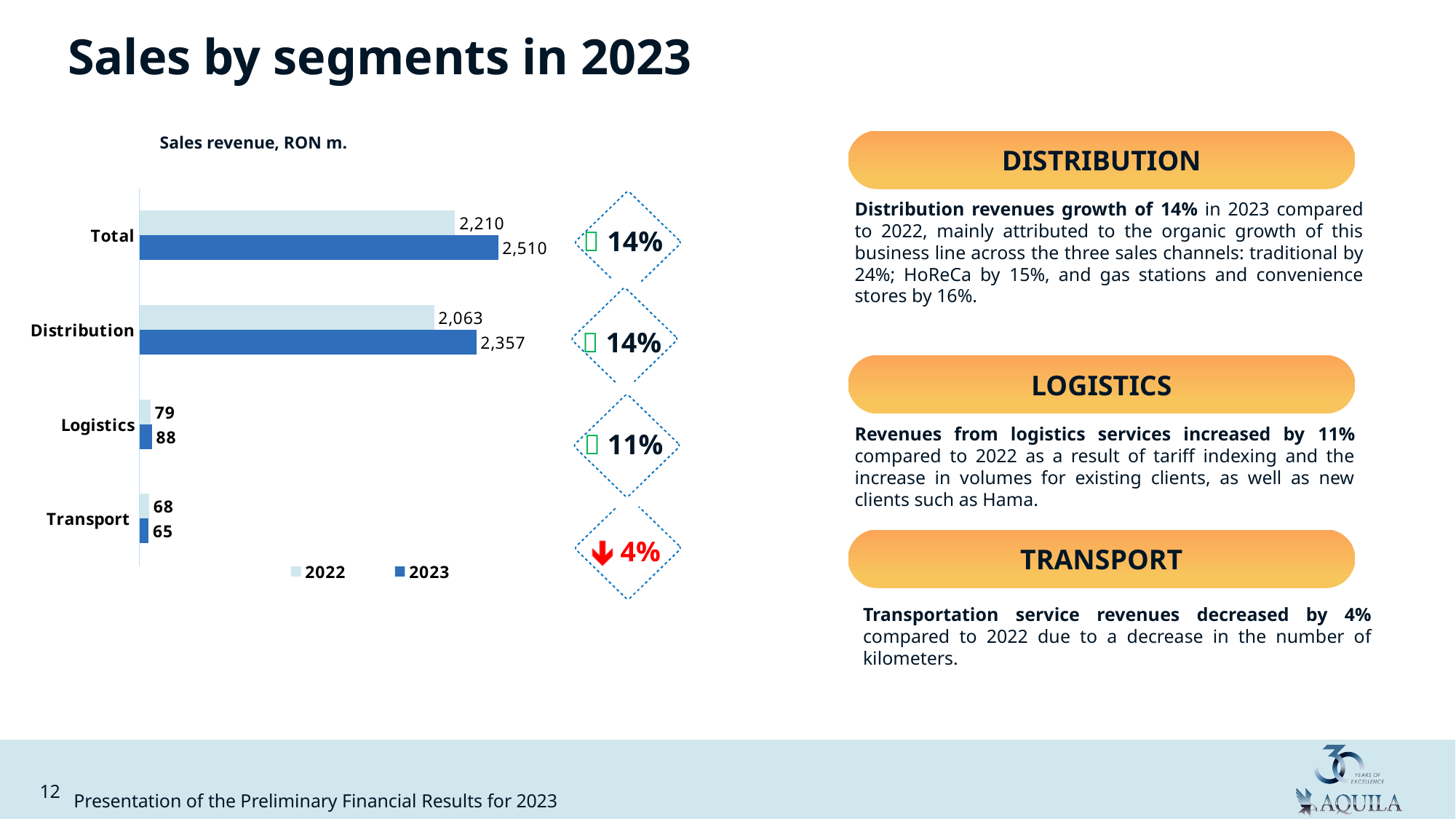
Excluding Total, which segment had the highest sales revenue in 2023? Distribution What type of chart is used to show sales revenue by segment? Bar chart What was the sales revenue for Transport in 2023? 65 What is the title of the chart? Sales revenue, RON m. Which segment had the lowest sales revenue in 2023? Transport Which is larger: Transport sales revenue in 2022 or in 2023? 2022 What is the difference between the Total sales revenue in 2023 and in 2022? 300 What was the sales revenue for Distribution in 2023? 2,357 What is the difference between Logistics sales revenue in 2023 and 2022? 9 How many series does the chart legend list? 2 What was the Total sales revenue in 2023? 2,510 What was the sales revenue for Logistics in 2022? 79